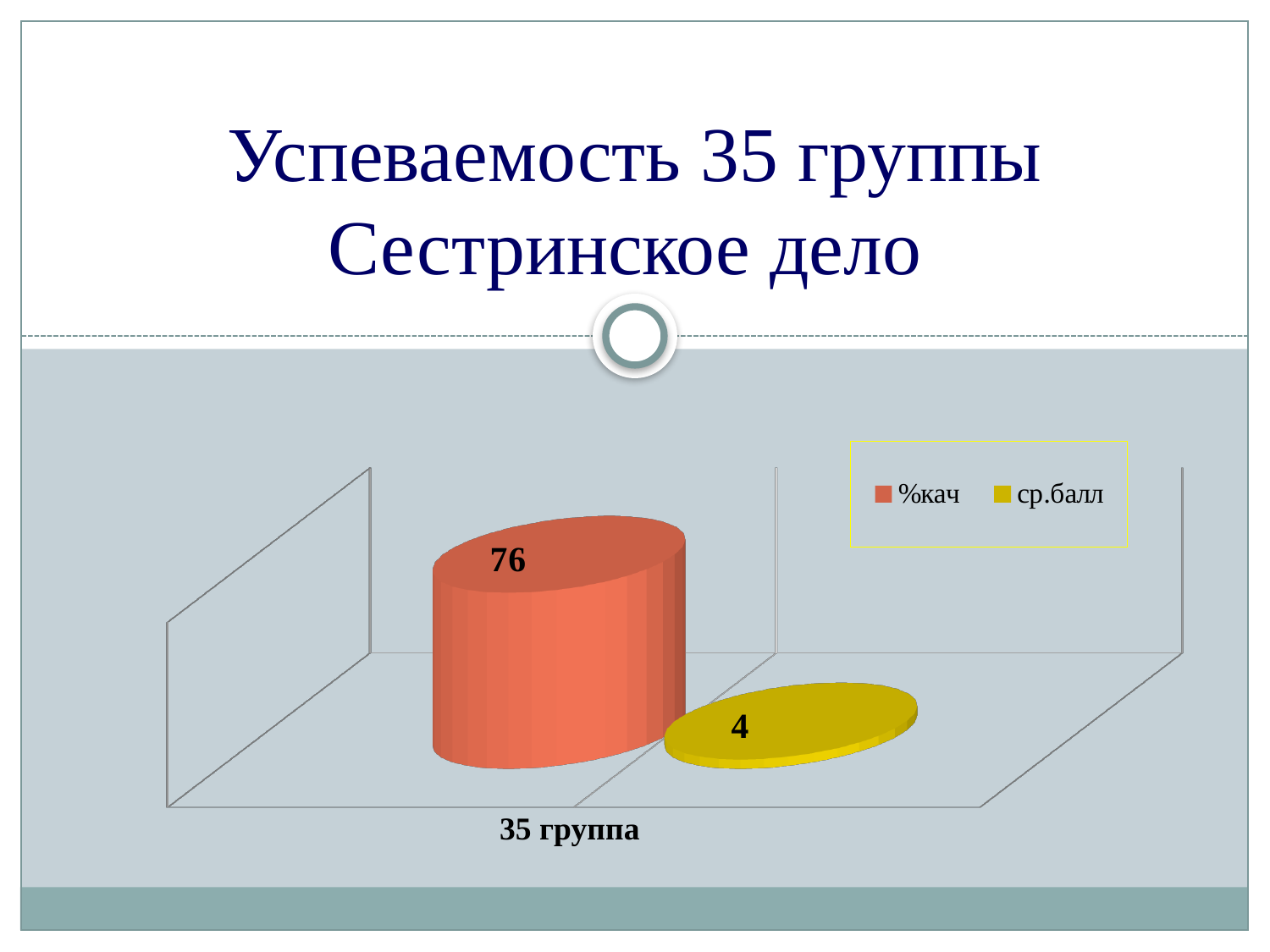
Which series has the higher value for 35 группа, %кач or ср.балл? %кач What is the category label shown on the x axis? 35 группа What is the difference between the %кач value and the ср.балл value for 35 группа? 72 Which series has the lowest value on the chart? ср.балл What is the value of %кач for 35 группа? 76 How many categories are shown on the x axis? 1 How many series does the legend list? 2 Which series has the highest value on the chart? %кач What is the value of ср.балл for 35 группа? 4 What kind of chart is shown on the slide? bar chart Which series is shown in yellow in the legend? ср.балл